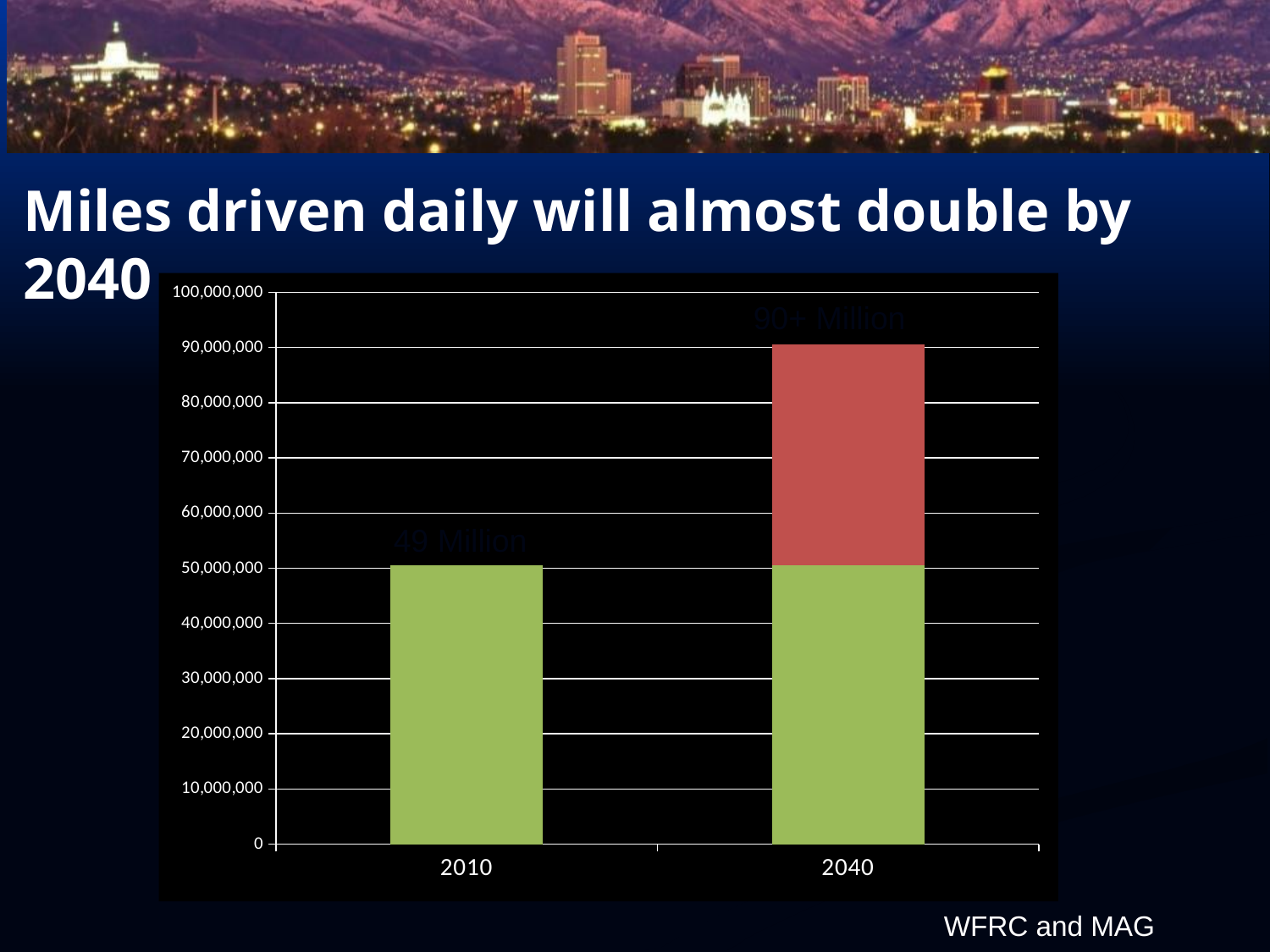
Which is larger, the value for 2010 or the value for 2040? 2040 Is the total value for 2040 greater or less than 80,000,000? greater What colour is the top segment of the 2040 bar? red Is the total value for 2010 greater or less than 40,000,000? greater Is the total value for 2040 greater or less than 100,000,000? less Which year has the taller bar in the chart? 2040 How many categories are shown on the x axis of the chart? 2 Which year has the shorter bar in the chart? 2010 What kind of chart is shown on the slide? bar chart What is the title of the slide containing the chart? Miles driven daily will almost double by 2040 Do the values rise or fall from 2010 to 2040? rise